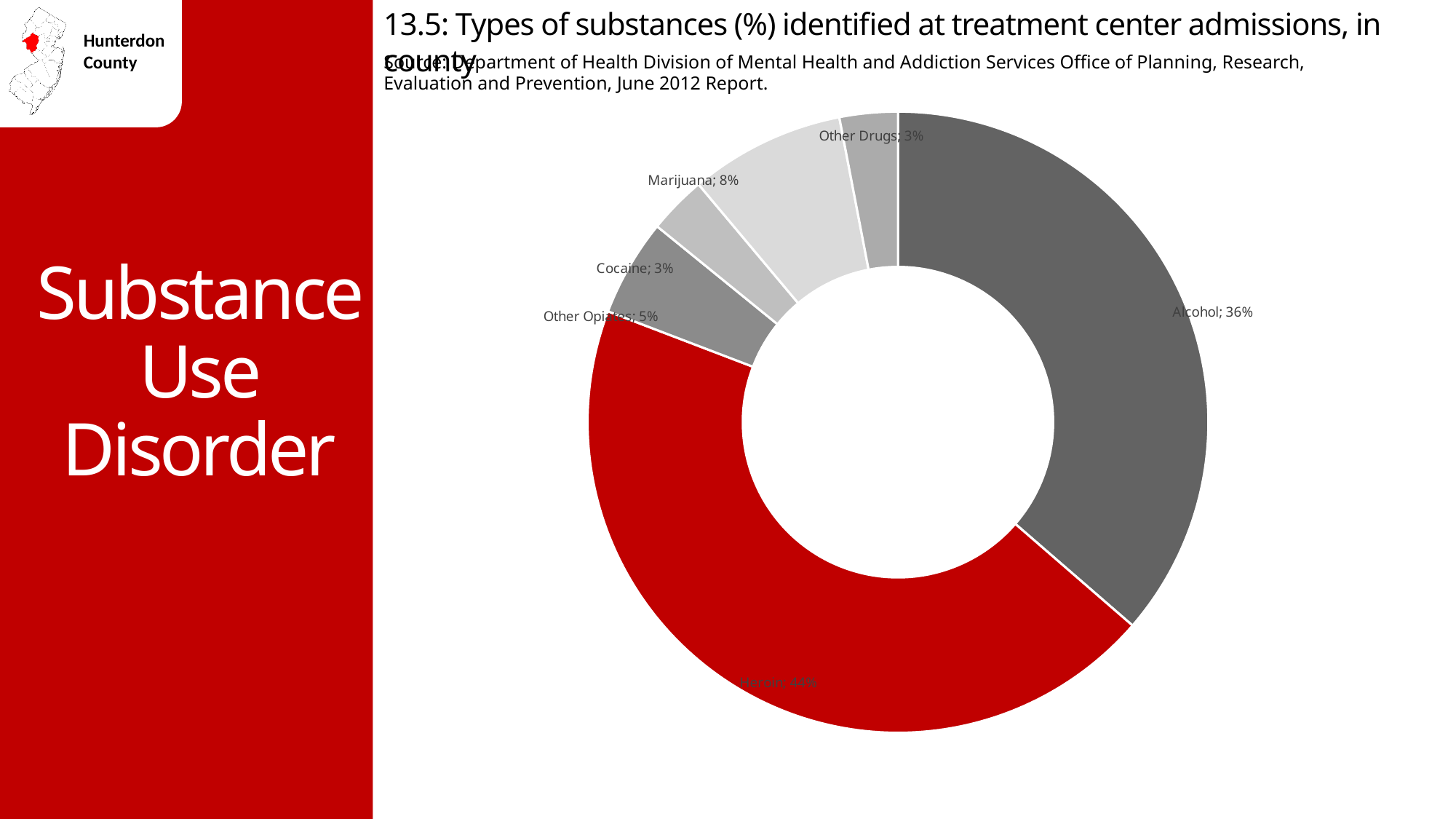
What percentage is shown for Cocaine? 3% What value is shown for Marijuana? 8% How many percentage points higher is Heroin than Alcohol? 8 What percentage is shown for Other Opiates? 5% Which is larger, the share for Marijuana or the share for Other Opiates? Marijuana What colour is the Heroin slice? Red What percentage is shown for Alcohol? 36% What is the combined share of Heroin and Alcohol? 80% Which substance has the largest share of admissions? Heroin How many substance categories are shown in the chart? 6 What kind of chart is used on this slide? Doughnut chart What percentage of treatment center admissions is attributed to Heroin? 44%